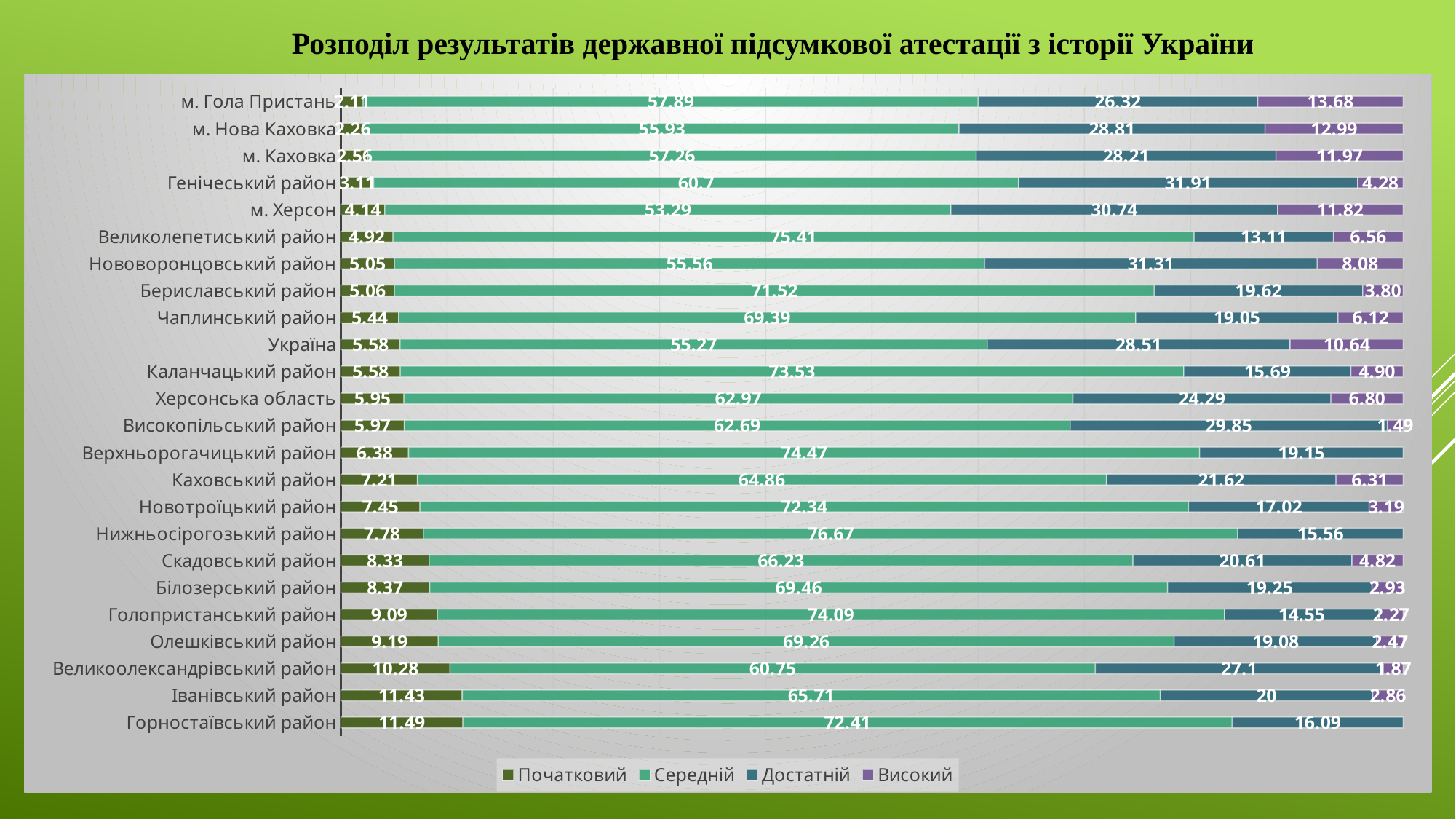
What kind of chart is shown on the slide? stacked bar chart How many categories (regions/cities) are plotted on the chart? 24 What is the Середній value for Україна? 55.27 Which category has the lowest Середній value? м. Херсон Which colour represents the Високий series in the legend? purple Which has the larger Достатній value, Генічеський район or Каланчацький район? Генічеський район What is the Високий value for Високопільський район? 1.49 What is the difference between the Середній values of Великолепетиський район and Україна? 20.14 Which category has the highest Середній value? Нижньосірогозький район How many series does the legend list? 4 Which category has the highest Високий value? м. Гола Пристань What is the Достатній value for Херсонська область? 24.29